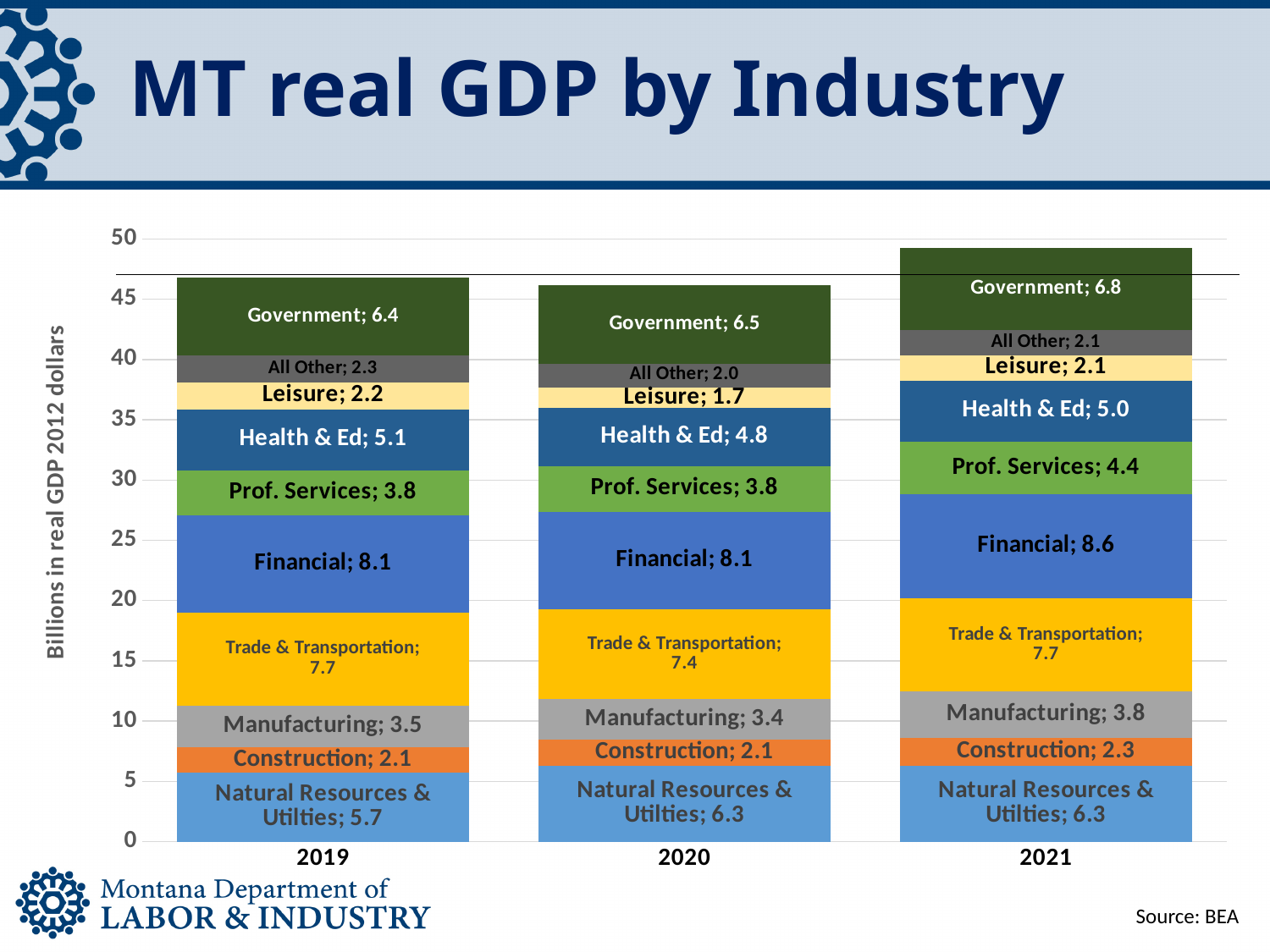
How many years (bars) are shown on the x axis? 3 What is the value for Financial in 2021? 8.6 What is the label on the vertical axis? Billions in real GDP 2012 dollars Is the Manufacturing value larger in 2020 or in 2021? 2021 What type of chart is shown on the slide? Stacked bar chart What is the value for Natural Resources & Utilities in 2019? 5.7 Which year has the tallest total bar? 2021 What is the value for Health & Ed in 2020? 4.8 What is the value for Government in 2021? 6.8 What is the total of the 2019 stacked bar? 46.9 Which industry segment is the largest in the 2021 bar? Financial What is the difference between the Leisure value in 2019 and in 2020? 0.5